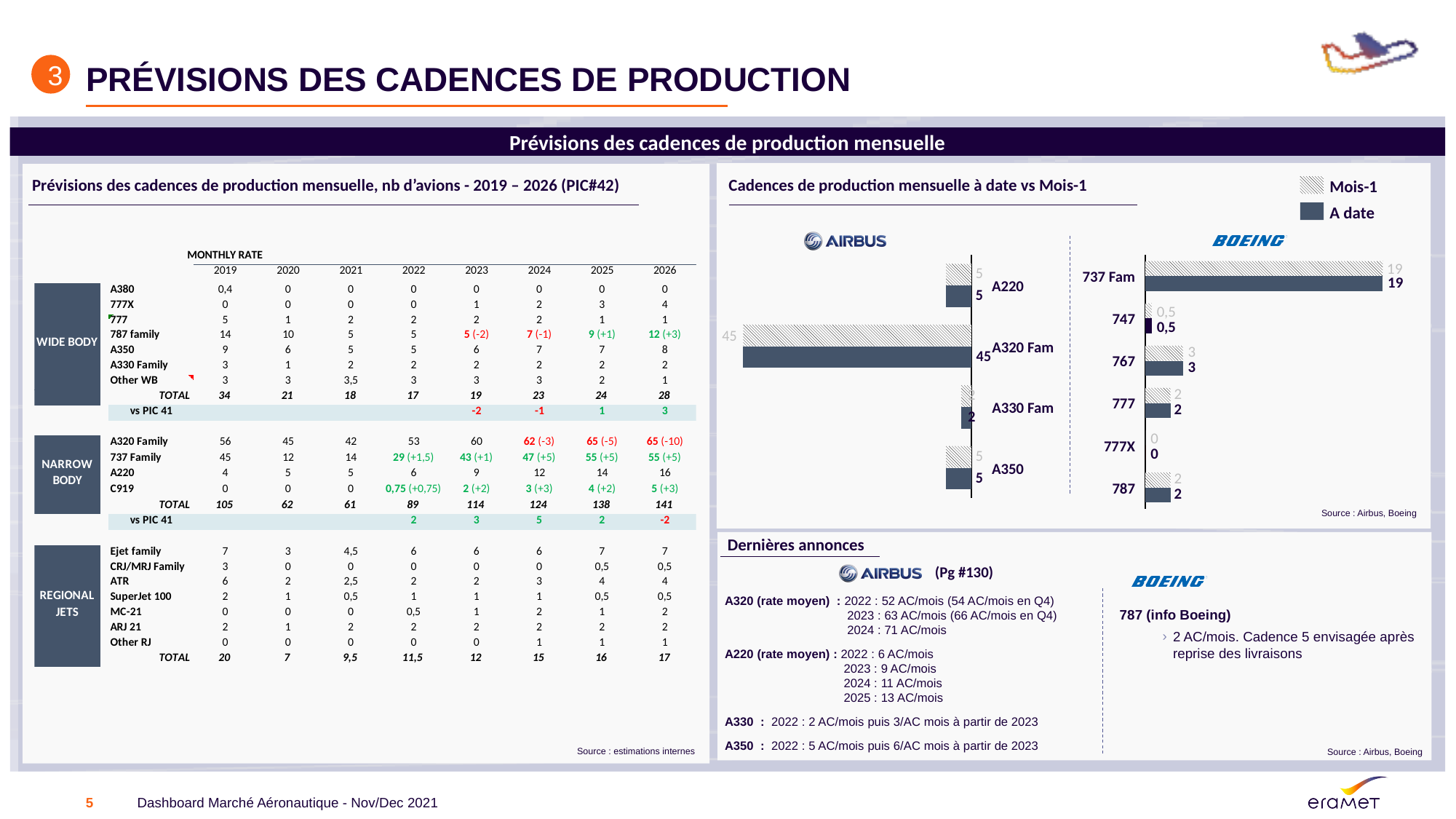
In the Airbus chart, what is the 'A date' value for the A350? 5 In the Airbus chart, which aircraft family has the highest 'A date' production rate? A320 Fam In the Airbus chart (Cadences de production mensuelle à date vs Mois-1), what is the 'A date' value for A320 Fam? 45 In the Boeing chart, which aircraft has the highest 'A date' production rate? 737 Fam In the Boeing chart, which aircraft has the lowest 'A date' production rate? 777X How many aircraft categories are shown in the Boeing chart? 6 How many series does the legend of the 'Cadences de production mensuelle à date vs Mois-1' charts list? 2 In the Boeing chart (Cadences de production mensuelle à date vs Mois-1), what is the 'A date' value for 737 Fam? 19 In the Boeing chart, which is larger, the 'A date' value for 767 or for 787? 767 What type of chart is used for 'Cadences de production mensuelle à date vs Mois-1'? Bar chart In the Boeing chart, what is the difference between the 'A date' values for 767 and 777? 1 In the Boeing chart, what is the 'A date' value for the 747? 0,5